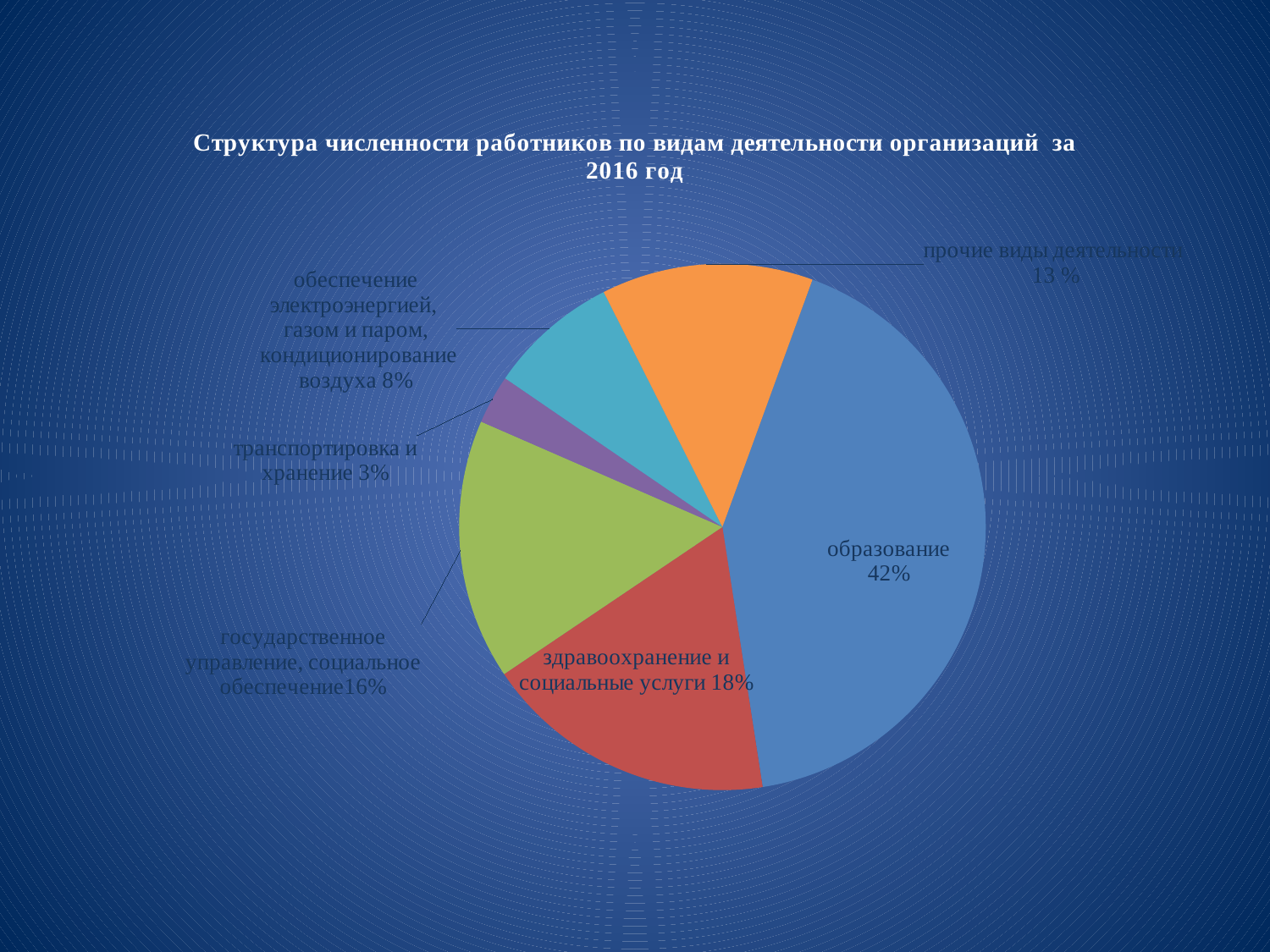
What is the difference in percentage points between образование and здравоохранение и социальные услуги? 24 Which activity type has the largest share of workers? образование How many slices does the pie chart have? 6 What share of workers is in прочие виды деятельности? 13 % What share of workers is in образование? 42% What share of workers is in обеспечение электроэнергией, газом и паром, кондиционирование воздуха? 8% What share of workers is in государственное управление, социальное обеспечение? 16% What share of workers is in здравоохранение и социальные услуги? 18% Which activity type has the smallest share of workers? транспортировка и хранение What kind of chart is shown on the slide? pie chart What share of workers is in транспортировка и хранение? 3% Which has a larger share: прочие виды деятельности or обеспечение электроэнергией, газом и паром, кондиционирование воздуха? прочие виды деятельности